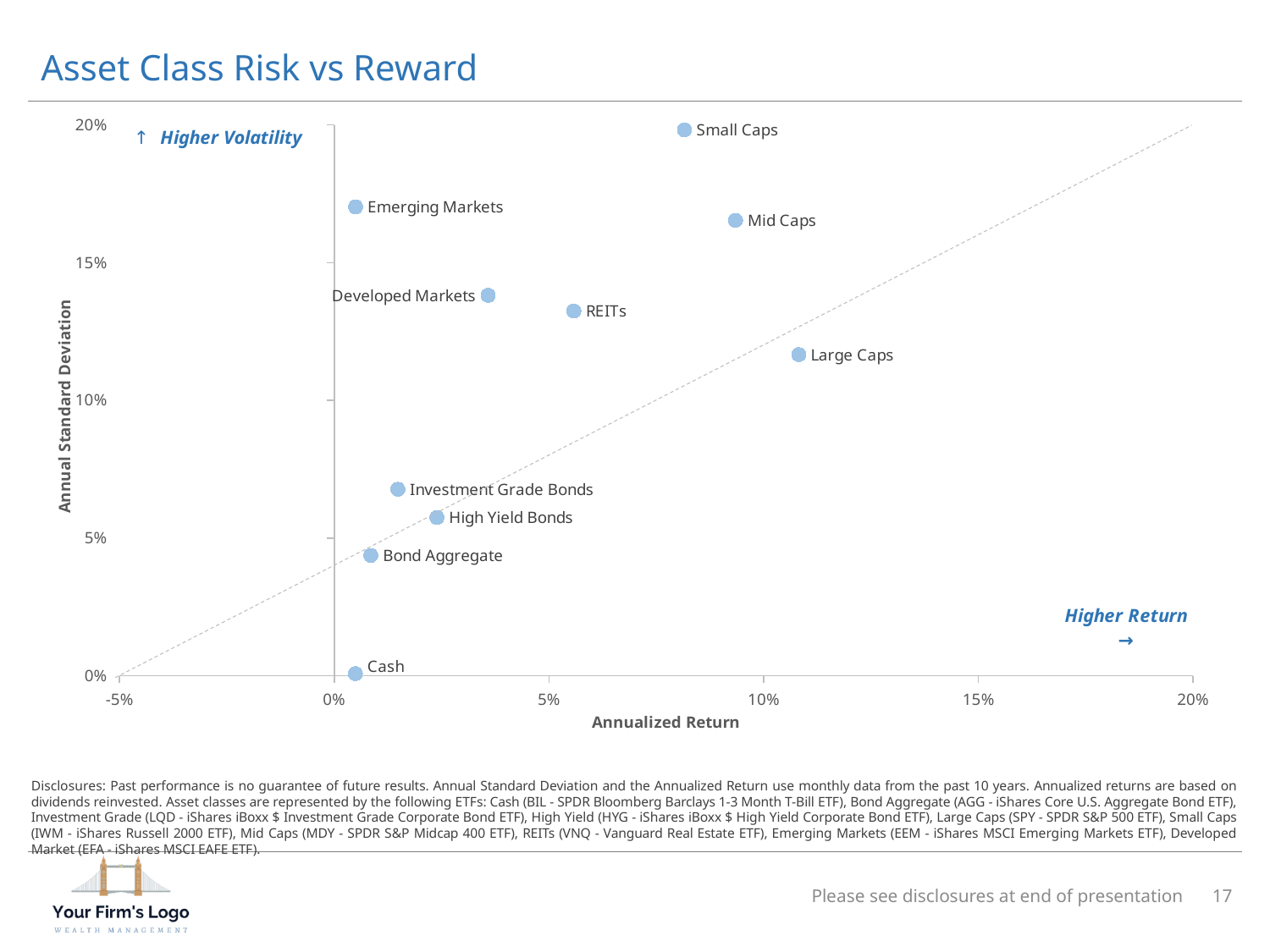
Is the annual standard deviation for Investment Grade Bonds greater or less than 5%? greater Which asset class has the lowest annual standard deviation? Cash Which has a higher annual standard deviation, Small Caps or Mid Caps? Small Caps Is the annualized return for Developed Markets greater or less than 5%? less What kind of chart is shown on the slide? Scatter chart Is the annual standard deviation for Small Caps greater or less than 15%? greater Which asset class has the highest annualized return? Large Caps What is the title of the chart's x axis? Annualized Return Which asset class has the highest annual standard deviation? Small Caps Which has a higher annualized return, Large Caps or REITs? Large Caps How many asset classes are plotted on the chart? 10